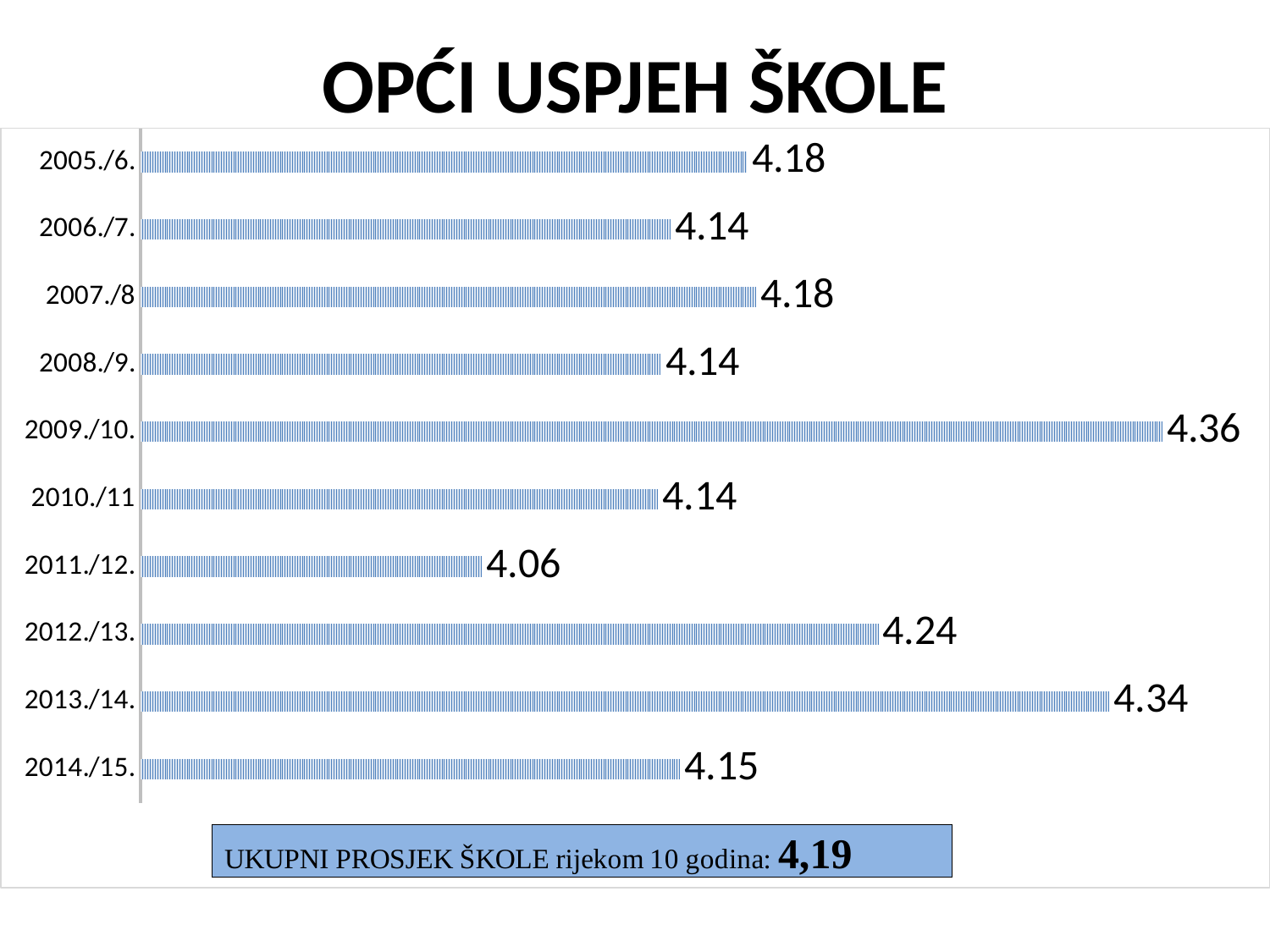
What is the difference between the values for 2013./14. and 2012./13.? 0.10 Which school year has the lowest value? 2011./12. What is the value for 2009./10.? 4.36 How many school years are shown in the chart? 10 Which school year has the highest value? 2009./10. Which is larger, the value for 2013./14. or the value for 2014./15.? 2013./14. What kind of chart is shown on the slide? bar chart What is the difference between the values for 2009./10. and 2011./12.? 0.30 What is the value for 2011./12.? 4.06 What is the title of the slide? OPĆI USPJEH ŠKOLE What is the value for 2014./15.? 4.15 What is the value for 2012./13.? 4.24